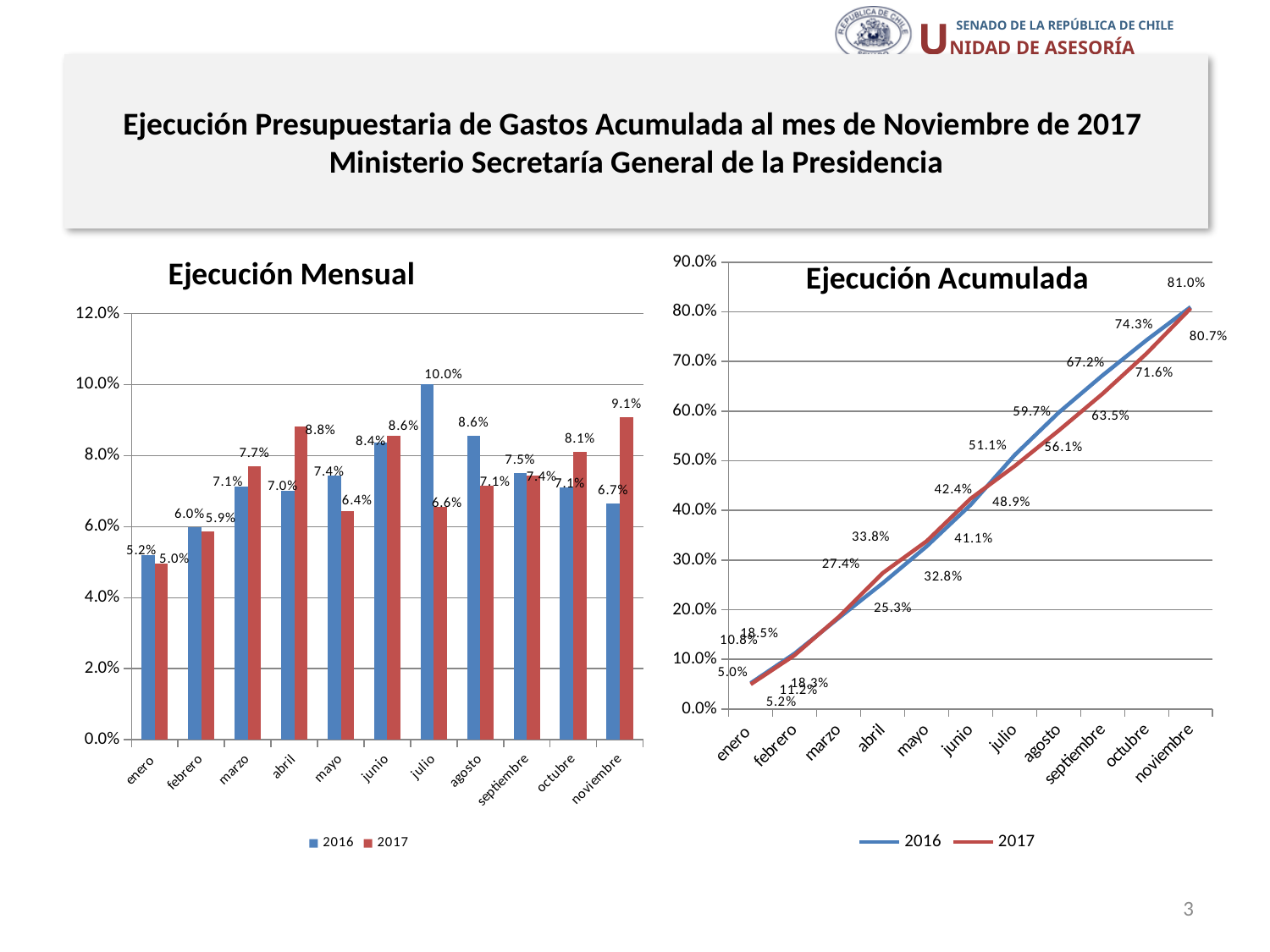
In the 'Ejecución Acumulada' chart, what is the value for 2016 in noviembre? 81.0% In the 'Ejecución Mensual' chart, which series has the larger value in abril, 2016 or 2017? 2017 In the 'Ejecución Mensual' chart, what is the difference between the 2016 and 2017 values in julio? 3.4 percentage points In the 'Ejecución Acumulada' chart, what is the difference between the 2016 and 2017 values in octubre? 2.7 percentage points In the 'Ejecución Mensual' chart, what is the value for 2016 in julio? 10.0% How many series does the legend of the 'Ejecución Acumulada' chart list? 2 In the 'Ejecución Mensual' chart, which month has the lowest value for 2017? enero What kind of chart is the 'Ejecución Acumulada' chart on the right? Line chart In the 'Ejecución Mensual' chart, which month has the highest value for 2016? julio How many months are shown on the x axis of the 'Ejecución Mensual' chart? 11 What kind of chart is the 'Ejecución Mensual' chart on the left? Bar chart In the 'Ejecución Mensual' chart, what is the value for 2017 in noviembre? 9.1%